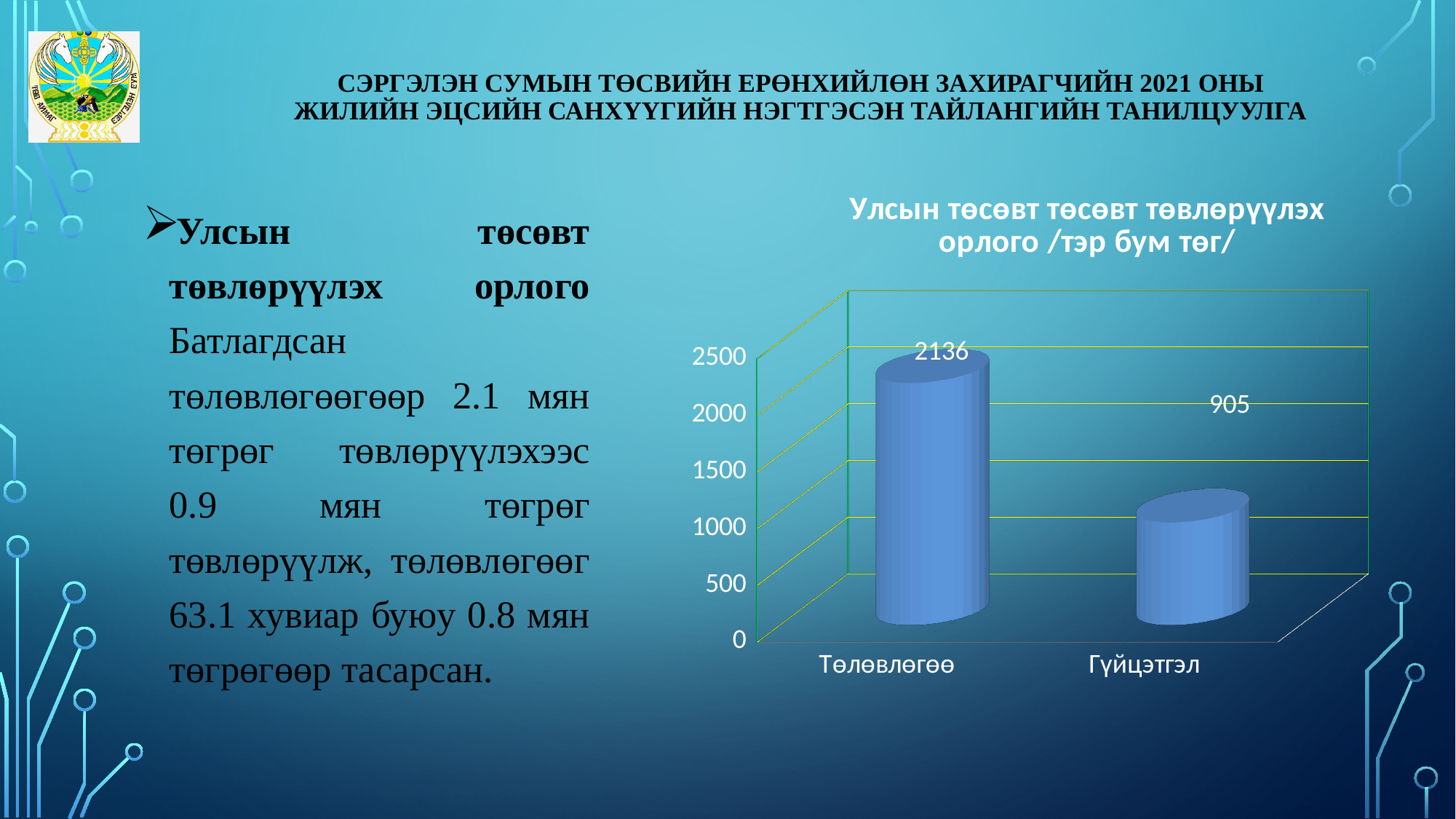
What is the value for Төлөвлөгөө? 2136 Which category has the lowest value? Гүйцэтгэл What is the value for Гүйцэтгэл? 905 Which category has the highest value? Төлөвлөгөө Is the value for Гүйцэтгэл greater or less than 1000? less What is the difference between the values for Төлөвлөгөө and Гүйцэтгэл? 1231 Which is larger, the value for Төлөвлөгөө or the value for Гүйцэтгэл? Төлөвлөгөө How many categories are shown on the chart? 2 What is the title of the chart? Улсын төсөвт төсөвт төвлөрүүлэх орлого /тэр бум төг/ What kind of chart is shown on the slide? bar chart Do the values rise or fall from Төлөвлөгөө to Гүйцэтгэл? fall Is the value for Төлөвлөгөө greater or less than 2000? greater